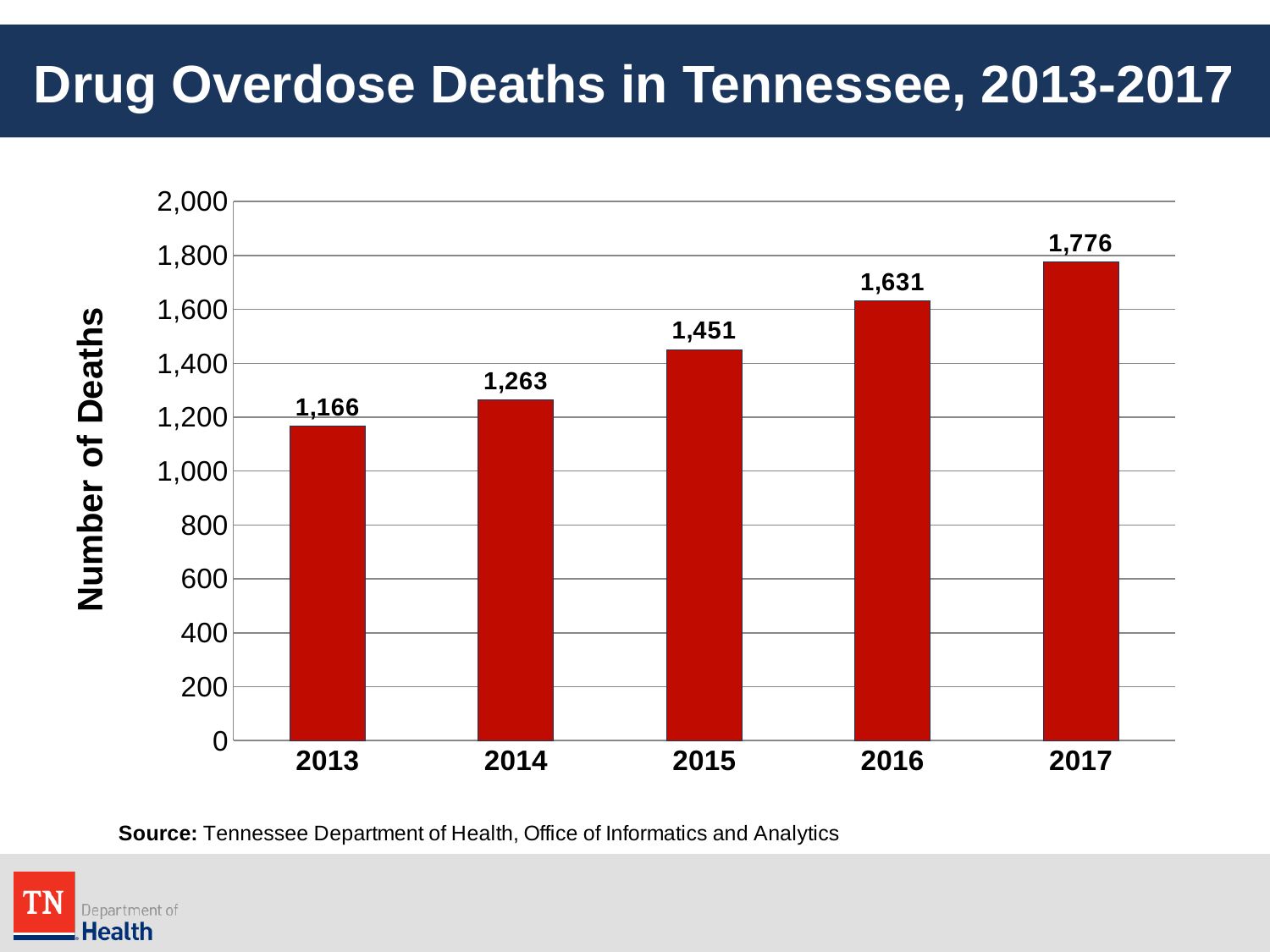
What is the difference in drug overdose deaths between 2017 and 2013? 610 Which year had the lowest number of drug overdose deaths? 2013 What kind of chart is shown on the slide? Bar chart What is the difference in drug overdose deaths between 2016 and 2015? 180 Which year had the highest number of drug overdose deaths? 2017 What was the number of drug overdose deaths in Tennessee in 2015? 1,451 What was the number of drug overdose deaths in Tennessee in 2017? 1,776 What was the number of drug overdose deaths in Tennessee in 2013? 1,166 Do drug overdose deaths rise or fall from 2013 to 2017? Rise How many years are shown on the chart? 5 Which year had more drug overdose deaths, 2014 or 2016? 2016 Is the value for 2016 greater or less than 1,600? greater